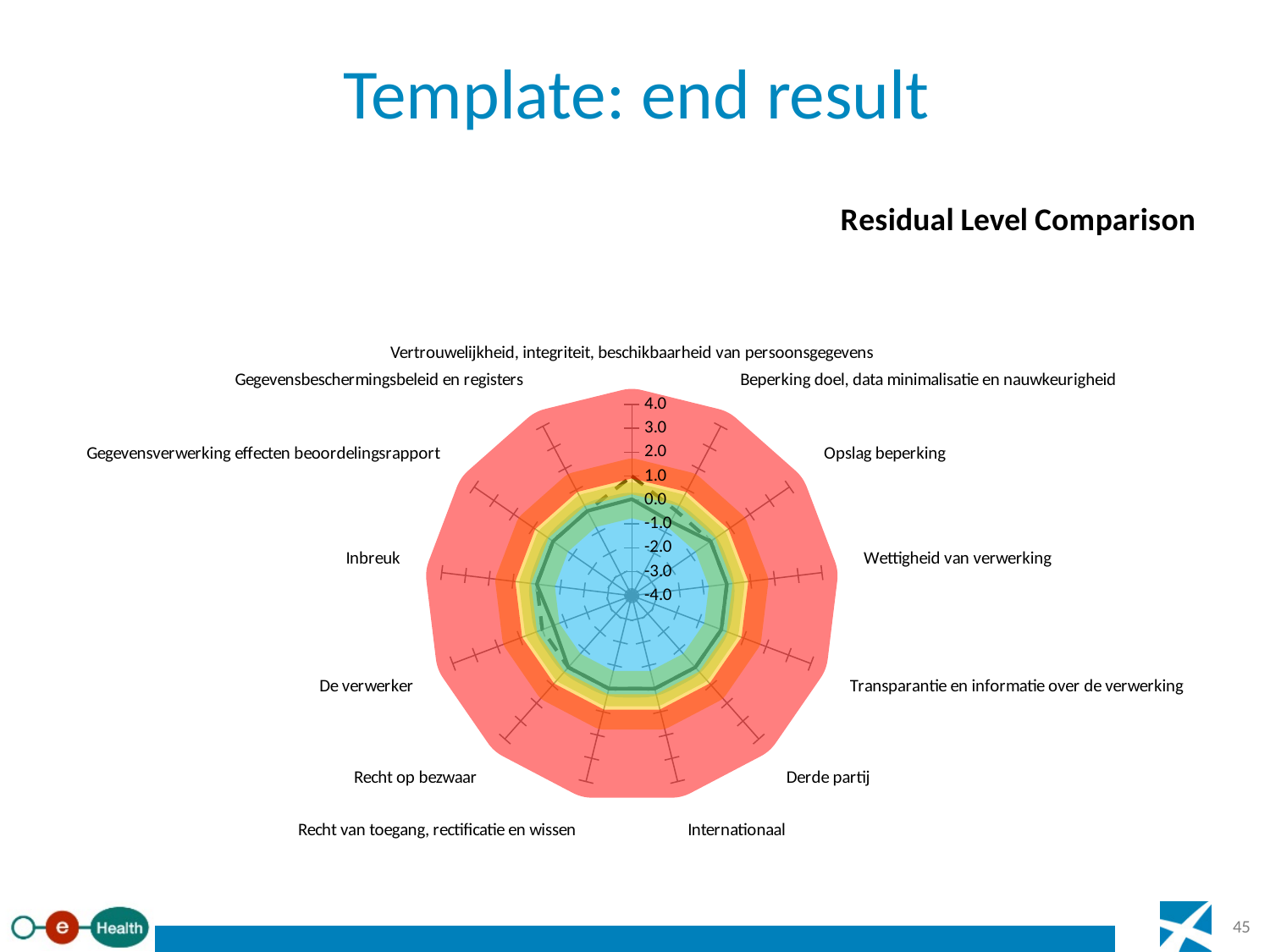
What is the highest value shown on the chart's radial axis? 4.0 How many categories (axes) does the radar chart have? 13 Is the plotted value for Inbreuk greater or less than -3.0? greater What kind of chart is shown on the slide? Radar chart What is the title of the chart? Residual Level Comparison Is the plotted value for Opslag beperking greater or less than 4.0? less